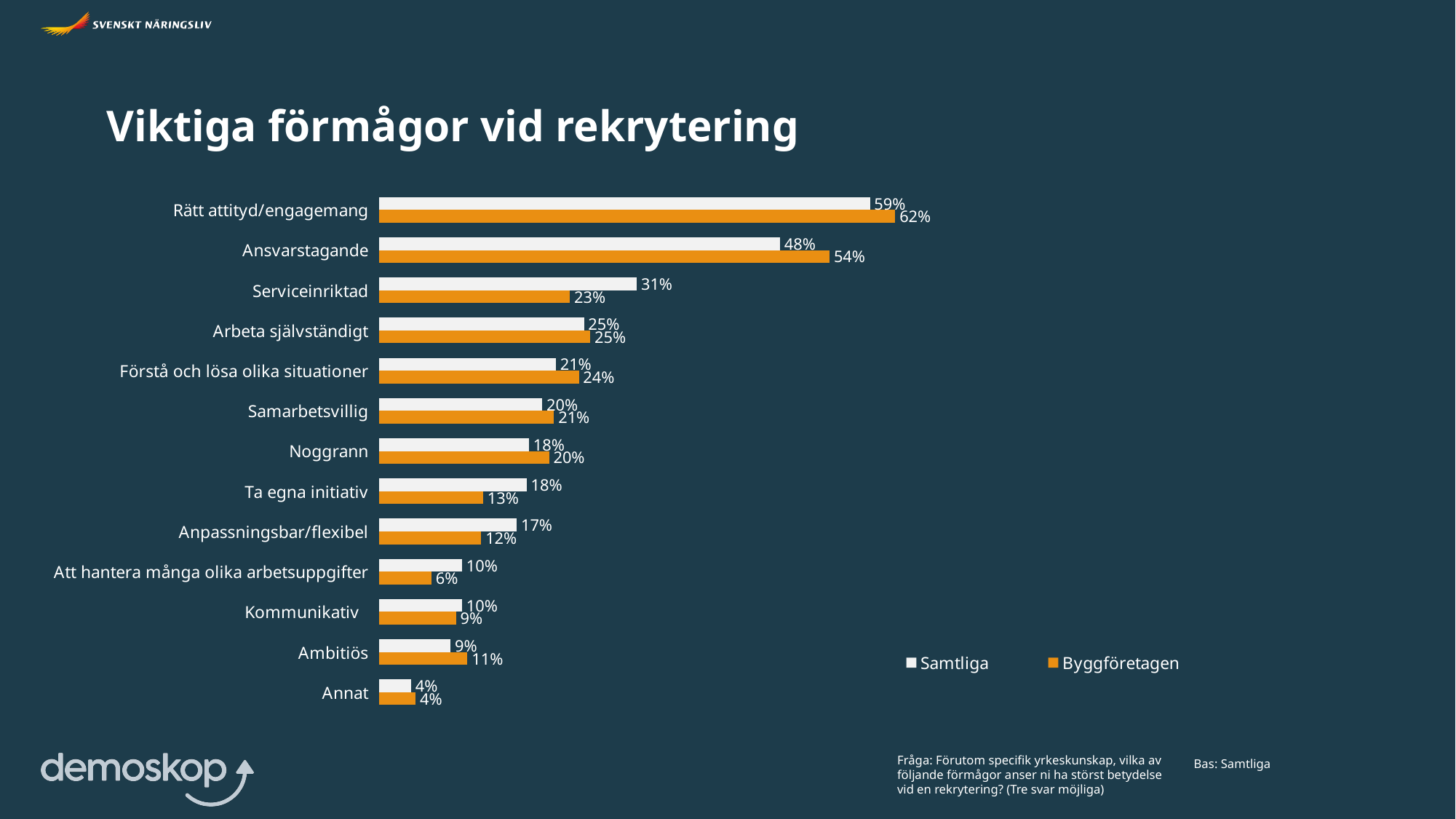
What is the value for Byggföretagen for Serviceinriktad? 23% How many categories are shown on the chart? 13 What is the value for Samtliga for Rätt attityd/engagemang? 59% Which category has the lowest value for Samtliga? Annat How many series does the legend list? 2 Which is larger for Ansvarstagande: Samtliga or Byggföretagen? Byggföretagen What is the title of the chart? Viktiga förmågor vid rekrytering What kind of chart is shown on the slide? Bar chart What is the value for Byggföretagen for Ansvarstagande? 54% What is the value for Samtliga for Ta egna initiativ? 18% Which category has the highest value for Byggföretagen? Rätt attityd/engagemang What is the difference between the Samtliga and Byggföretagen values for Serviceinriktad? 8 percentage points